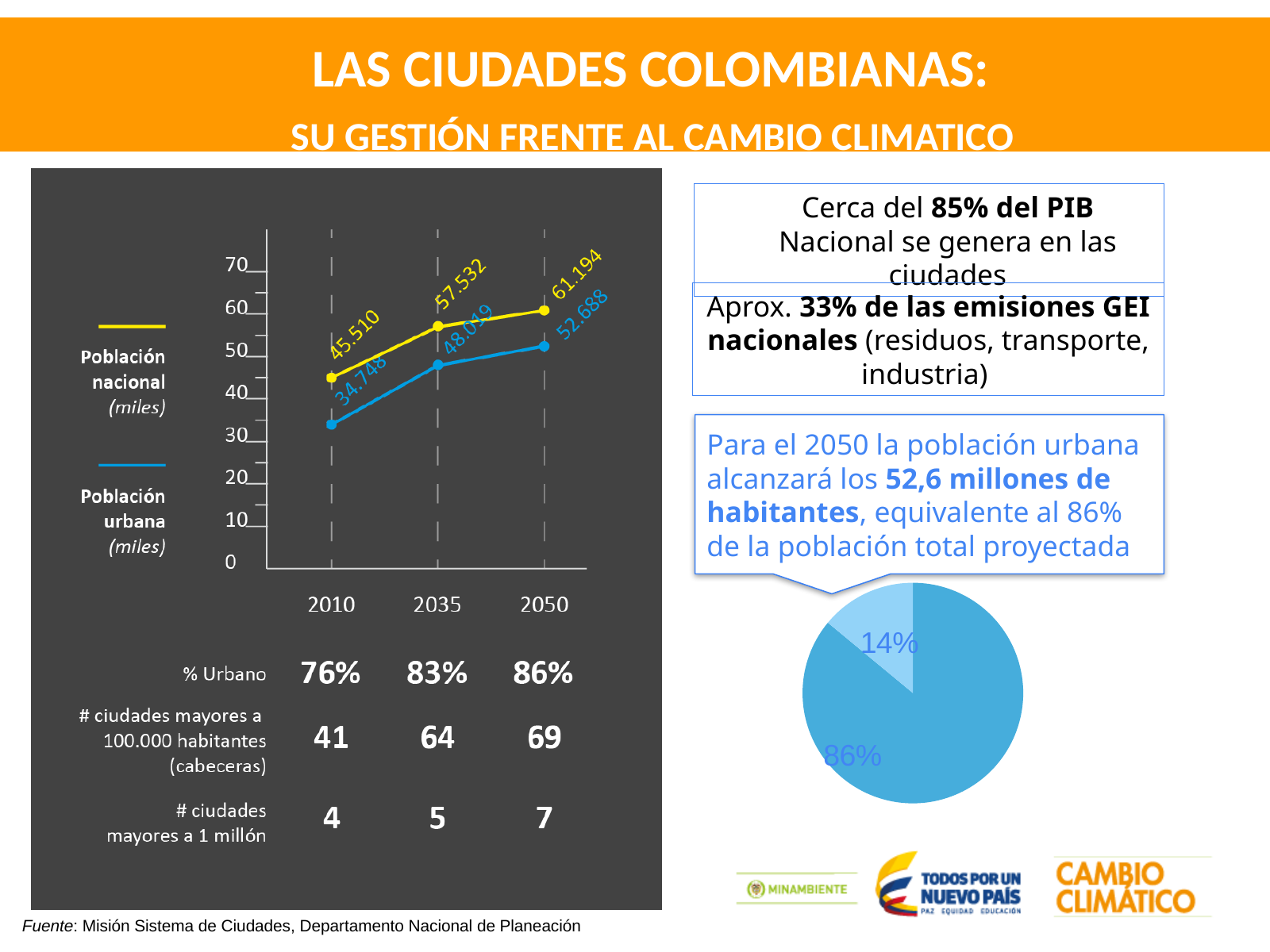
In the line chart on the left, in which year is Población nacional lowest? 2010 In the line chart on the left, what is the value for Población urbana in 2035? 48.039 In the line chart on the left, what is the value for Población urbana in 2010? 34.748 In the pie chart on the right, what share does the larger slice represent? 86% In the line chart on the left, how many years are shown on the x axis? 3 In the line chart on the left, what is the difference between Población nacional and Población urbana in 2050? 8.506 In the line chart on the left, what is the value for Población nacional in 2050? 61.194 In the line chart on the left, which is larger in 2035: Población nacional or Población urbana? Población nacional In the line chart on the left, does Población urbana rise or fall from 2010 to 2050? rise In the line chart on the left, in which year is Población urbana highest? 2050 In the line chart on the left, what is the value for Población nacional in 2010? 45.510 In the line chart on the left, how many series does the legend list? 2